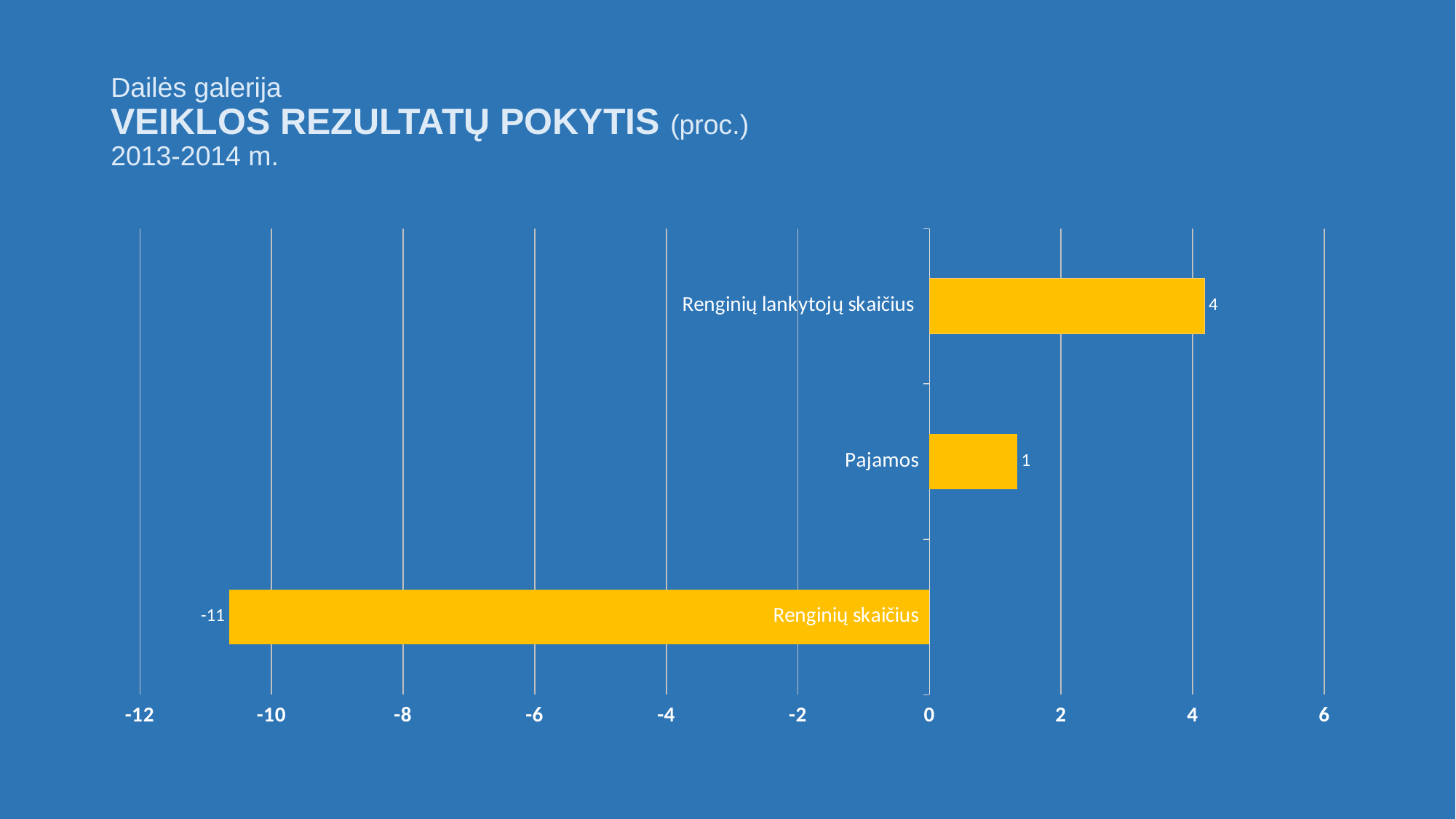
Which category has the lowest value? Renginių skaičius Which is larger, the value for Pajamos or the value for Renginių lankytojų skaičius? Renginių lankytojų skaičius What is the difference between the values for Renginių lankytojų skaičius and Pajamos? 3 What is the difference between the values for Renginių lankytojų skaičius and Renginių skaičius? 15 What unit does the chart title say the values are in? proc. What is the value for Renginių skaičius? -11 What is the value for Renginių lankytojų skaičius? 4 What is the value for Pajamos? 1 Which category has the highest value? Renginių lankytojų skaičius How many categories are shown in the chart? 3 What kind of chart is shown on the slide? bar chart Is the value for Renginių skaičius greater or less than -8? less